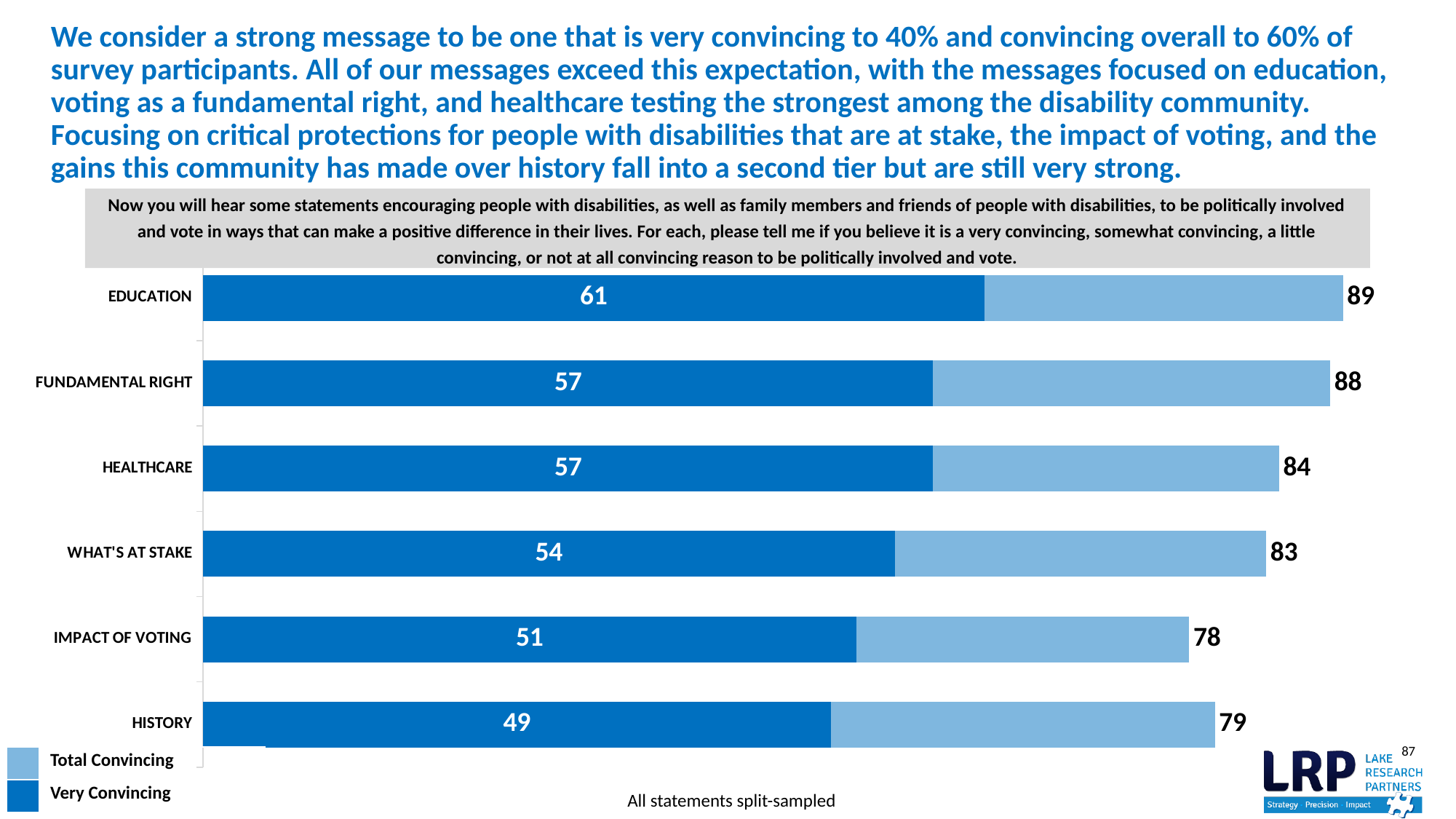
What is the Total Convincing value for HEALTHCARE? 84 What type of chart is shown on the slide? Bar chart What is the Total Convincing value for HISTORY? 79 What is the Very Convincing value for IMPACT OF VOTING? 51 Which message has the highest Very Convincing value? EDUCATION How many series does the legend list? 2 How many messages are shown in the chart? 6 Which message has the lowest Very Convincing value? HISTORY What is the Very Convincing value for EDUCATION? 61 What is the difference between the Total Convincing and Very Convincing values for EDUCATION? 28 Which is larger: the Total Convincing value for HISTORY or for IMPACT OF VOTING? HISTORY Which message has the lowest Total Convincing value? IMPACT OF VOTING